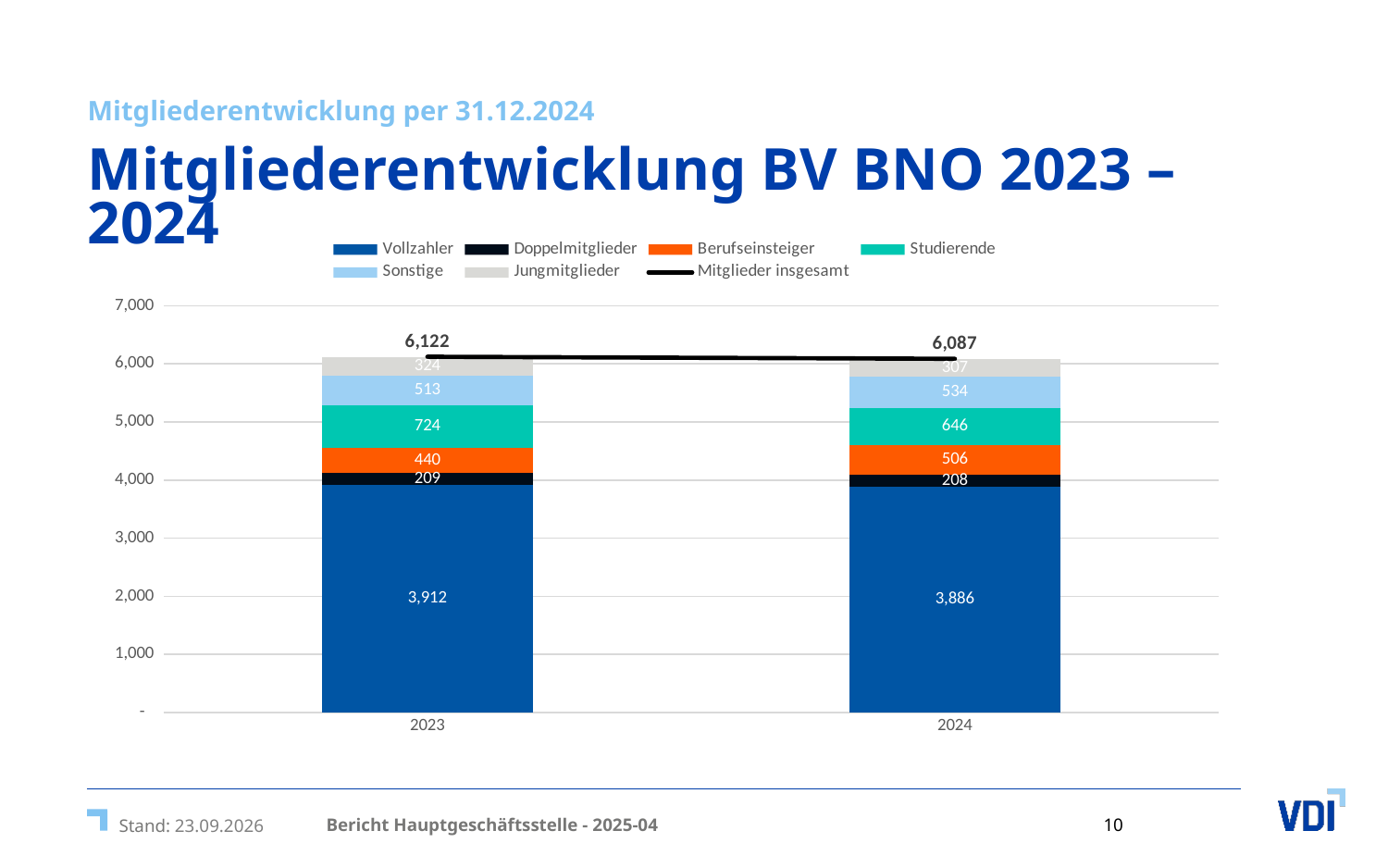
What is the Berufseinsteiger value for 2024? 506 What is the difference between the Mitglieder insgesamt values for 2023 and 2024? 35 Which year has the larger Vollzahler value, 2023 or 2024? 2023 How many years are shown on the x axis? 2 How many series does the legend list? 7 Which year has the larger Berufseinsteiger value, 2023 or 2024? 2024 What is the Vollzahler value for 2023? 3,912 What is the difference between the Studierende values for 2023 and 2024? 78 What is the Mitglieder insgesamt value for 2024? 6,087 What is the Sonstige value for 2024? 534 Does the Mitglieder insgesamt line rise or fall from 2023 to 2024? fall What is the Studierende value for 2023? 724